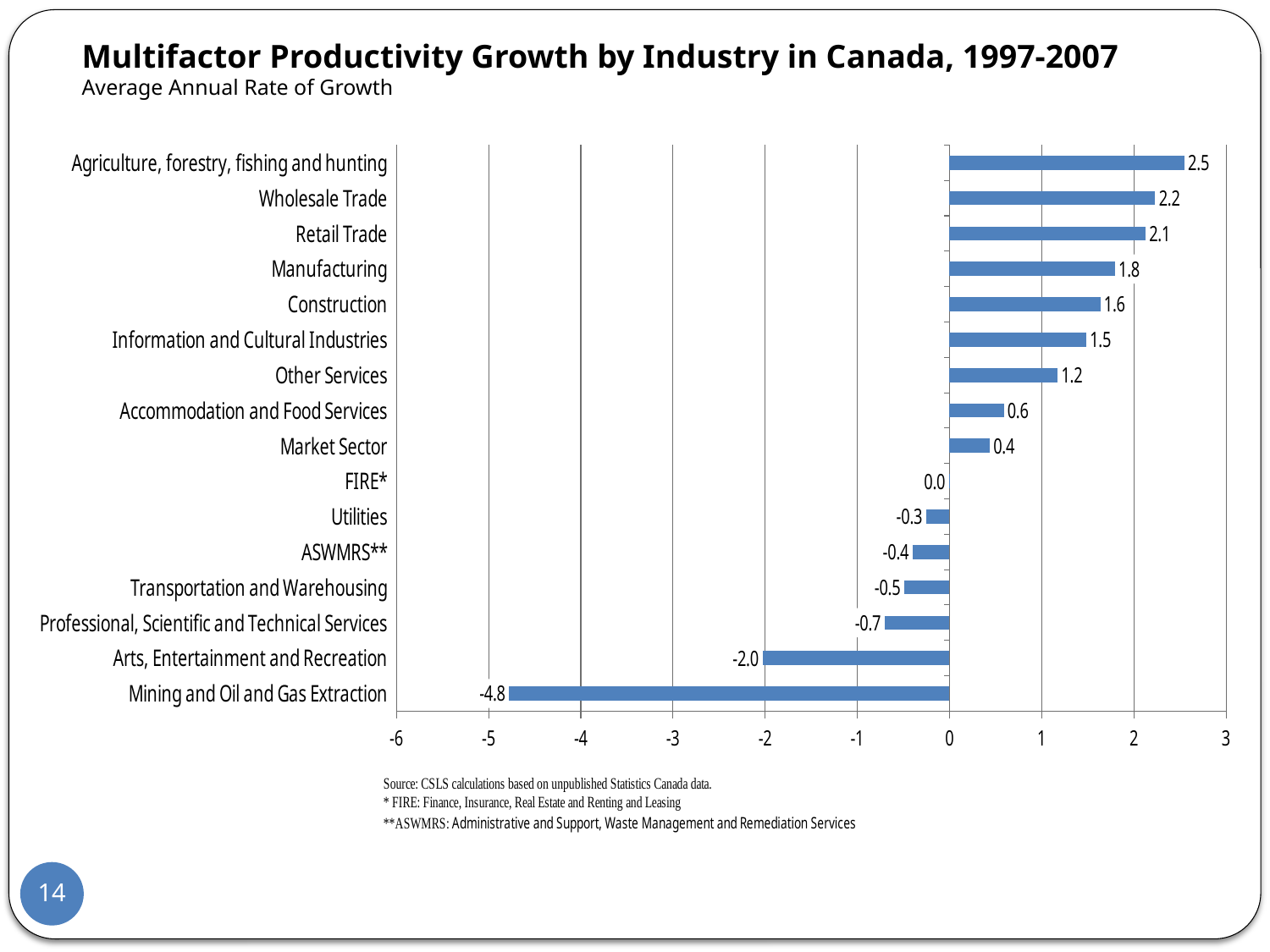
What is the difference between the values for Agriculture, forestry, fishing and hunting and Arts, Entertainment and Recreation? 4.5 What is the title of the chart on the slide? Multifactor Productivity Growth by Industry in Canada, 1997-2007 What is the average annual multifactor productivity growth rate for Manufacturing? 1.8 Which industry has the lowest multifactor productivity growth rate? Mining and Oil and Gas Extraction Which has a higher value, Construction or Other Services? Construction How many industries are shown in the chart? 16 What is the value shown for FIRE*? 0.0 What is the value shown for Mining and Oil and Gas Extraction? -4.8 Which has a lower value, Utilities or Transportation and Warehousing? Transportation and Warehousing What kind of chart is shown on the slide? Bar chart What is the difference between the values for Wholesale Trade and Retail Trade? 0.1 Which industry has the highest multifactor productivity growth rate? Agriculture, forestry, fishing and hunting